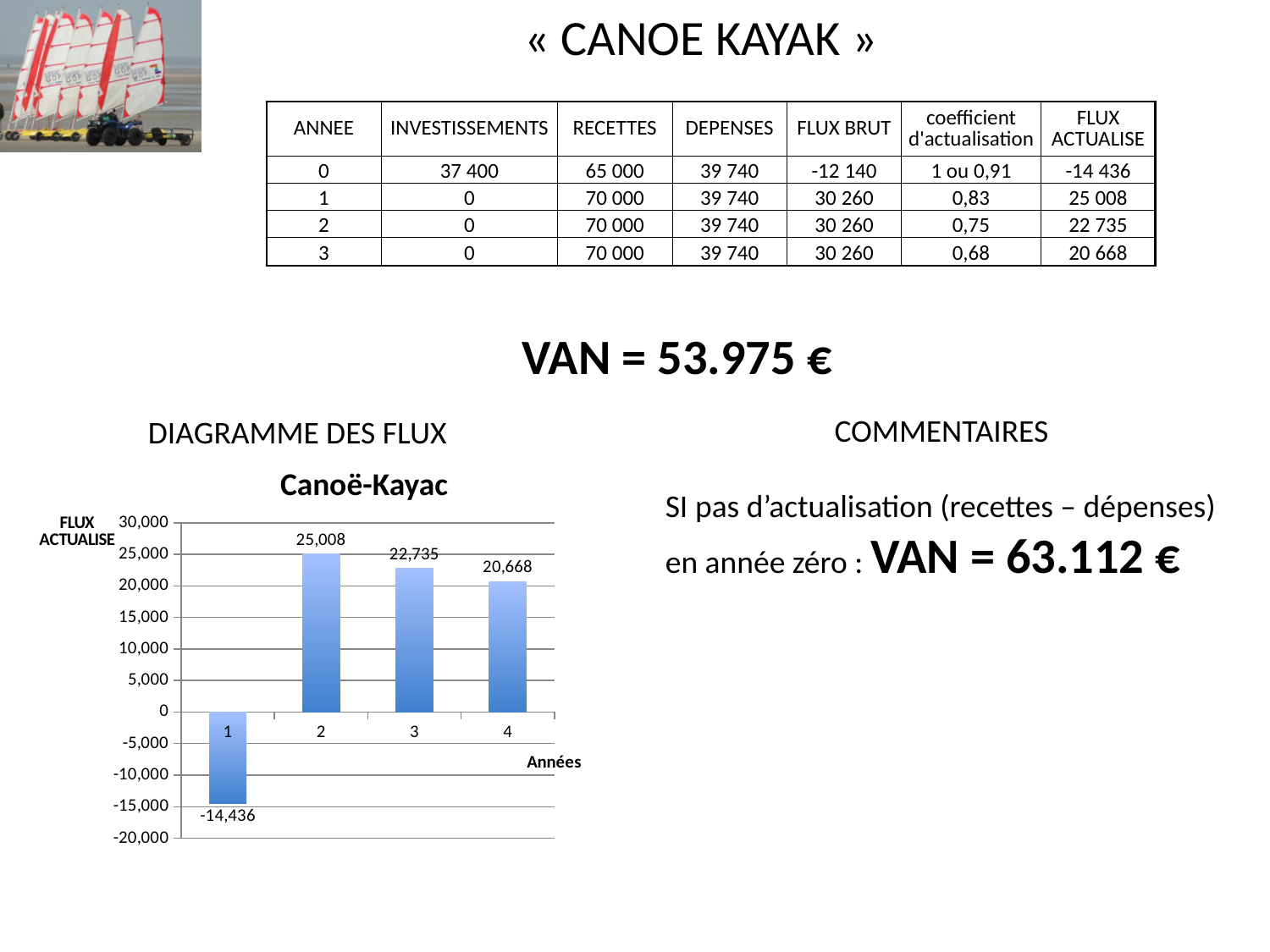
What kind of chart is the Canoë-Kayac chart? bar chart What is the difference between the values for year 2 and year 3 in the Canoë-Kayac chart? 2,273 Which is larger in the Canoë-Kayac chart, the value for year 3 or year 4? year 3 What is the value for year 3 in the Canoë-Kayac chart? 22,735 Which year has the highest value in the Canoë-Kayac chart? 2 What is the label on the x axis of the Canoë-Kayac chart? Années What is the value for year 1 in the Canoë-Kayac chart? -14,436 How many bars are plotted in the Canoë-Kayac chart? 4 Which year has the lowest value in the Canoë-Kayac chart? 1 Is the value for year 2 in the Canoë-Kayac chart greater or less than 20,000? greater What is the value for year 2 in the Canoë-Kayac chart? 25,008 What is the value for year 4 in the Canoë-Kayac chart? 20,668